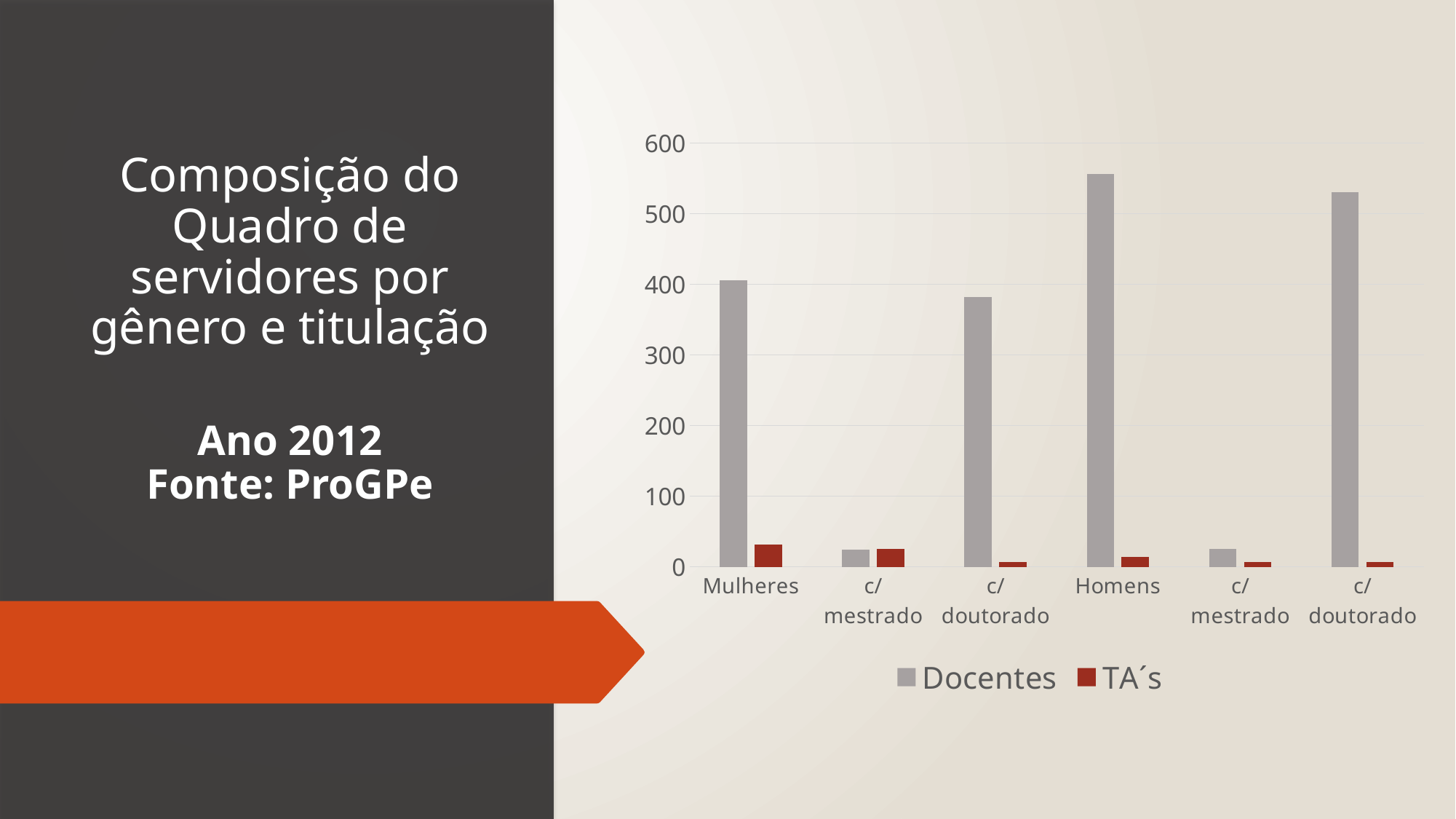
What kind of chart is shown on the slide? bar chart How many series does the chart legend list? 2 Is the TA´s value for Mulheres greater or less than 100? less What are the two series named in the chart legend? Docentes and TA´s Which category has the highest Docentes value? Homens Which is larger, the Docentes value for Mulheres or the Docentes value for the first c/ doutorado category (after Mulheres)? Mulheres Is the Docentes value for Mulheres greater or less than 300? greater How many categories are shown along the x axis of the chart? 6 What colour are the TA´s bars in the chart? dark red Which is larger, the Docentes value for Homens or the Docentes value for Mulheres? Homens Is the Docentes value for the first c/ doutorado category (after Mulheres) greater or less than 400? less